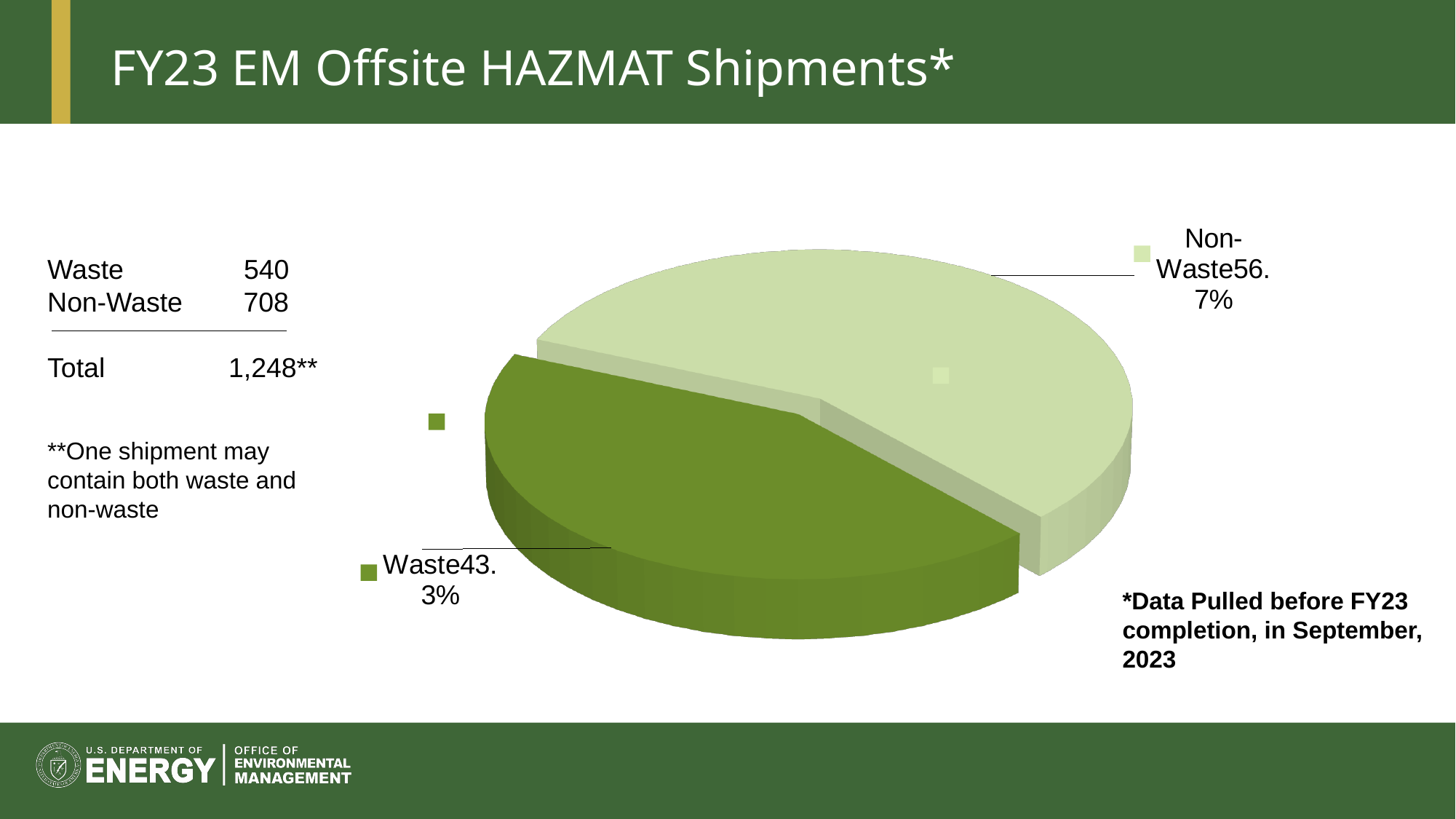
According to the figures on the slide, how many Waste shipments were there? 540 By how many percentage points does the Non-Waste share exceed the Waste share in the pie chart? 13.4 What is the title of the slide containing the pie chart? FY23 EM Offsite HAZMAT Shipments* What percentage of the pie chart is labelled for Waste? 43.3% Which slice of the pie chart is the smallest? Waste Which is larger in the pie chart, the Waste share or the Non-Waste share? Non-Waste What is the total number of shipments shown on the slide? 1,248 According to the figures on the slide, how many Non-Waste shipments were there? 708 How many slices does the pie chart have? 2 What percentage of the pie chart is labelled for Non-Waste? 56.7% Which slice of the pie chart is the largest? Non-Waste What type of chart is shown on the slide? Pie chart